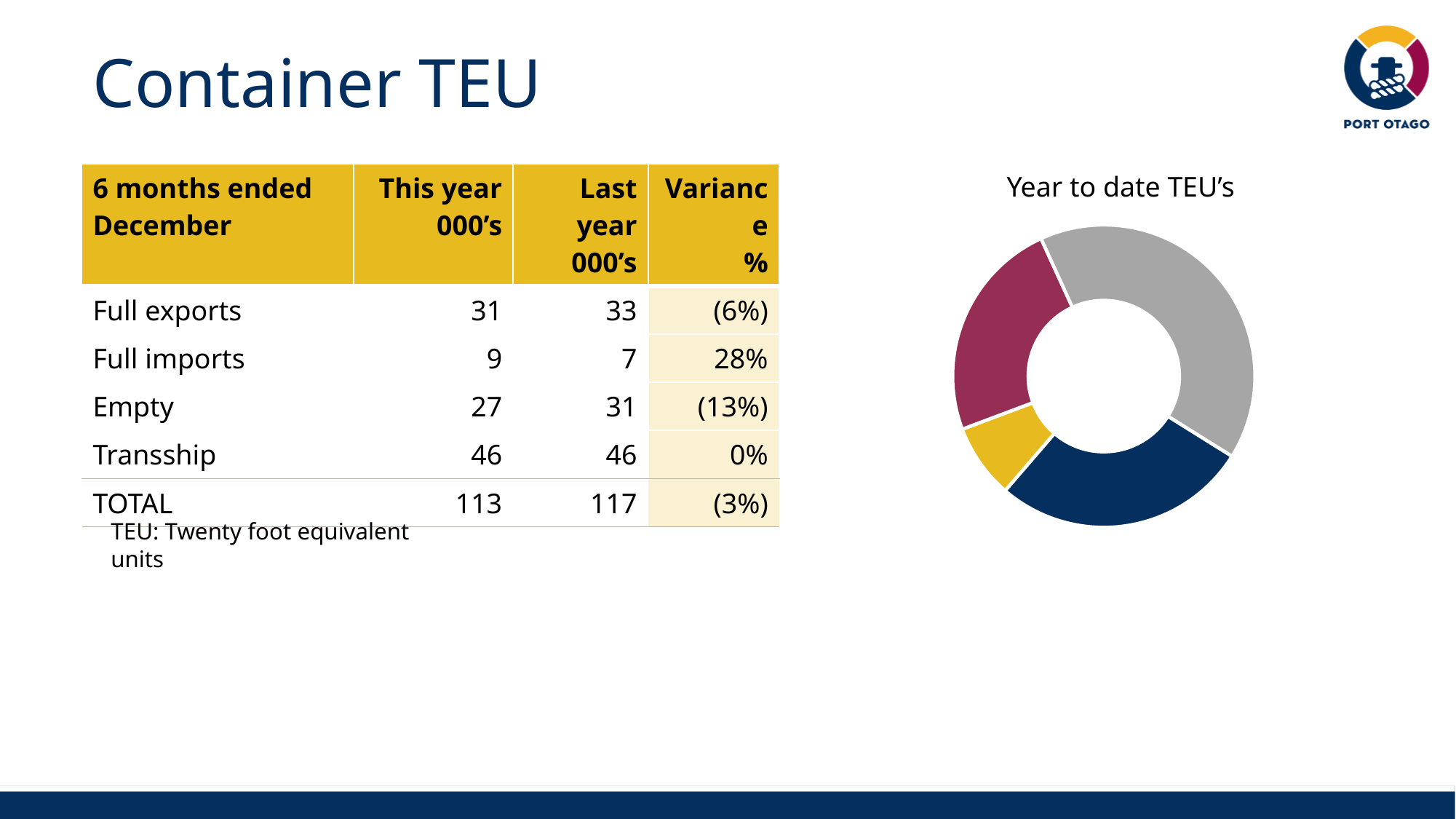
Which colour slice is the smallest in the doughnut chart? Yellow What is the title of the chart on the slide? Year to date TEU's In the doughnut chart, is the navy slice larger or smaller than the maroon slice? Larger Which colour slice is the largest in the doughnut chart? Grey In the doughnut chart, is the grey slice larger or smaller than the yellow slice? Larger What kind of chart is shown on the right of the slide? Doughnut chart Does the doughnut chart display a legend? No How many slices does the doughnut chart contain? 4